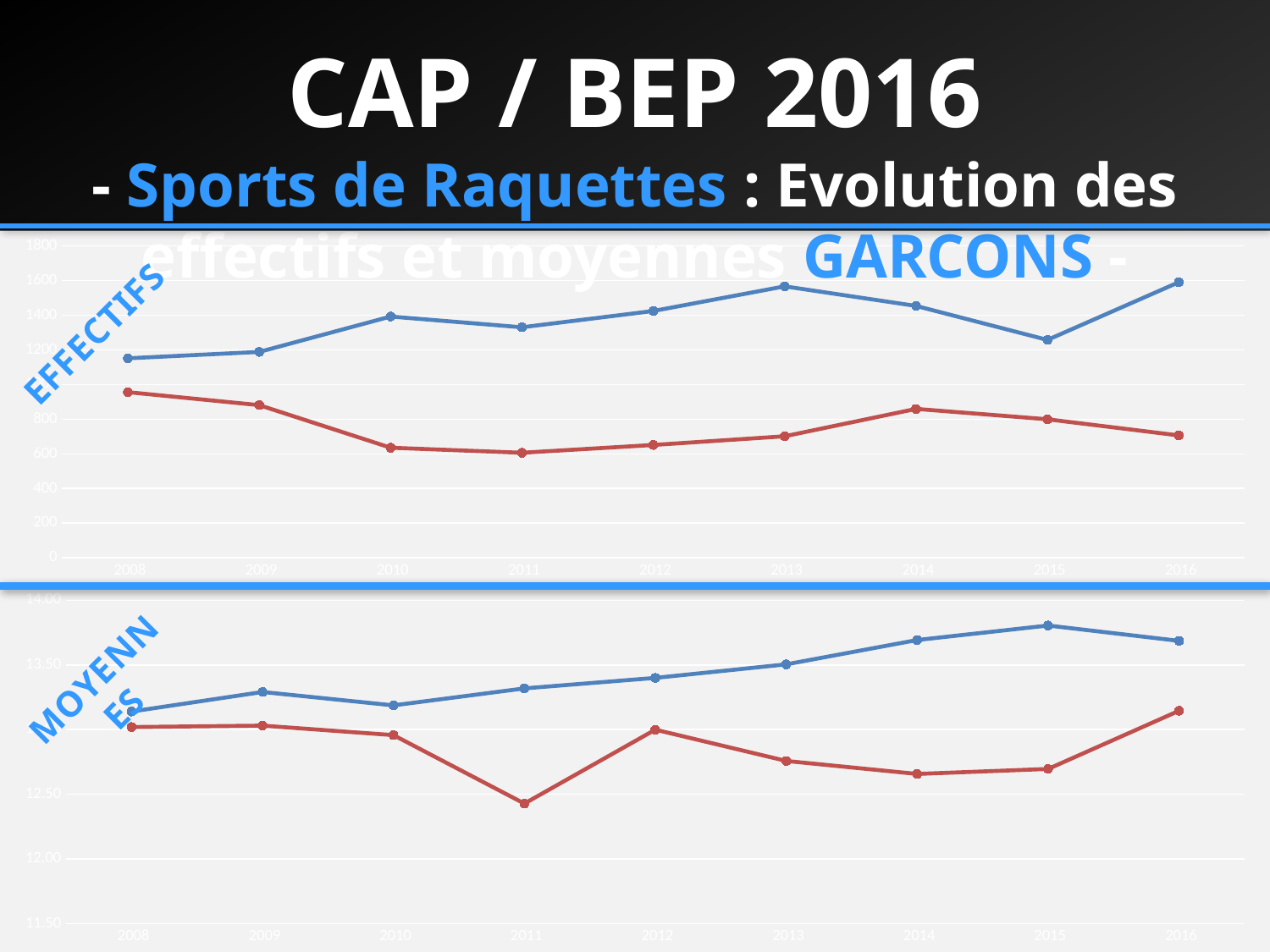
How many years are shown on the x axis of the top chart (EFFECTIFS)? 9 In the top chart (EFFECTIFS), is the value of the red line for 2008 greater or less than 800? greater In the top chart (EFFECTIFS), which line has the higher value in 2016, the blue line or the red line? the blue line What kind of chart is the top chart labelled EFFECTIFS? line chart In the bottom chart (MOYENNES), is the value of the blue line for 2015 greater or less than 13.50? greater In the top chart (EFFECTIFS), is the value of the blue line for 2013 greater or less than 1400? greater In the bottom chart (MOYENNES), in which year is the red line at its lowest? 2011 In the top chart (EFFECTIFS), in which year is the blue line at its lowest? 2008 In the bottom chart (MOYENNES), in which year is the blue line at its highest? 2015 In the top chart (EFFECTIFS), does the blue line rise or fall from 2008 to 2010? rises